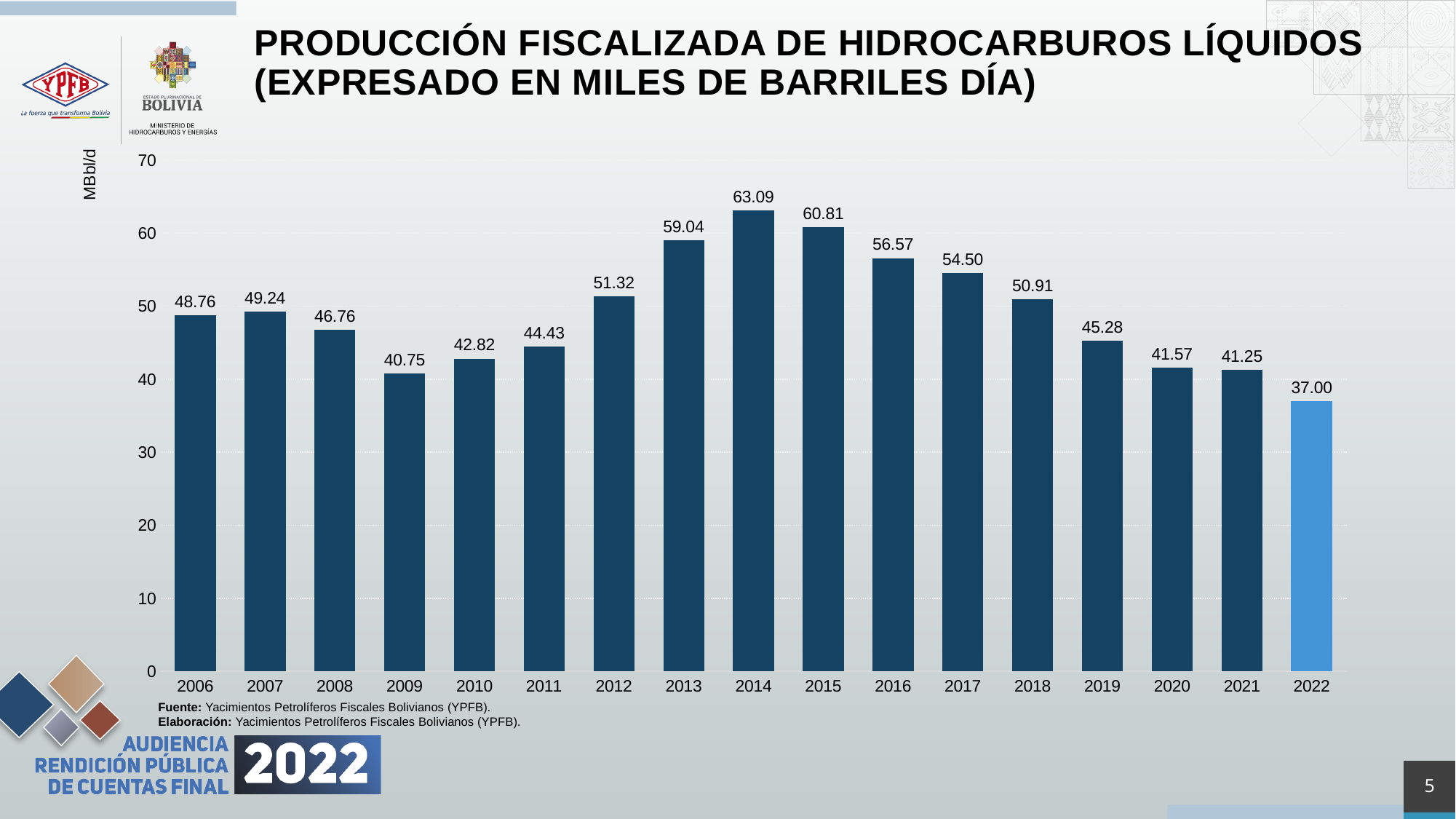
What kind of chart is shown? bar chart What is the value for 2022? 37.00 Which is larger, the value for 2013 or the value for 2016? 2013 What is the value for 2014? 63.09 Do the values rise or fall from 2014 to 2022? fall What is the difference between the values for 2014 and 2022? 26.09 Is the value for 2017 greater or less than 50? greater What unit is shown on the y axis label? MBbl/d What is the value for 2009? 40.75 Which year has the lowest value? 2022 How many years are shown on the x axis? 17 Which year has the highest value? 2014